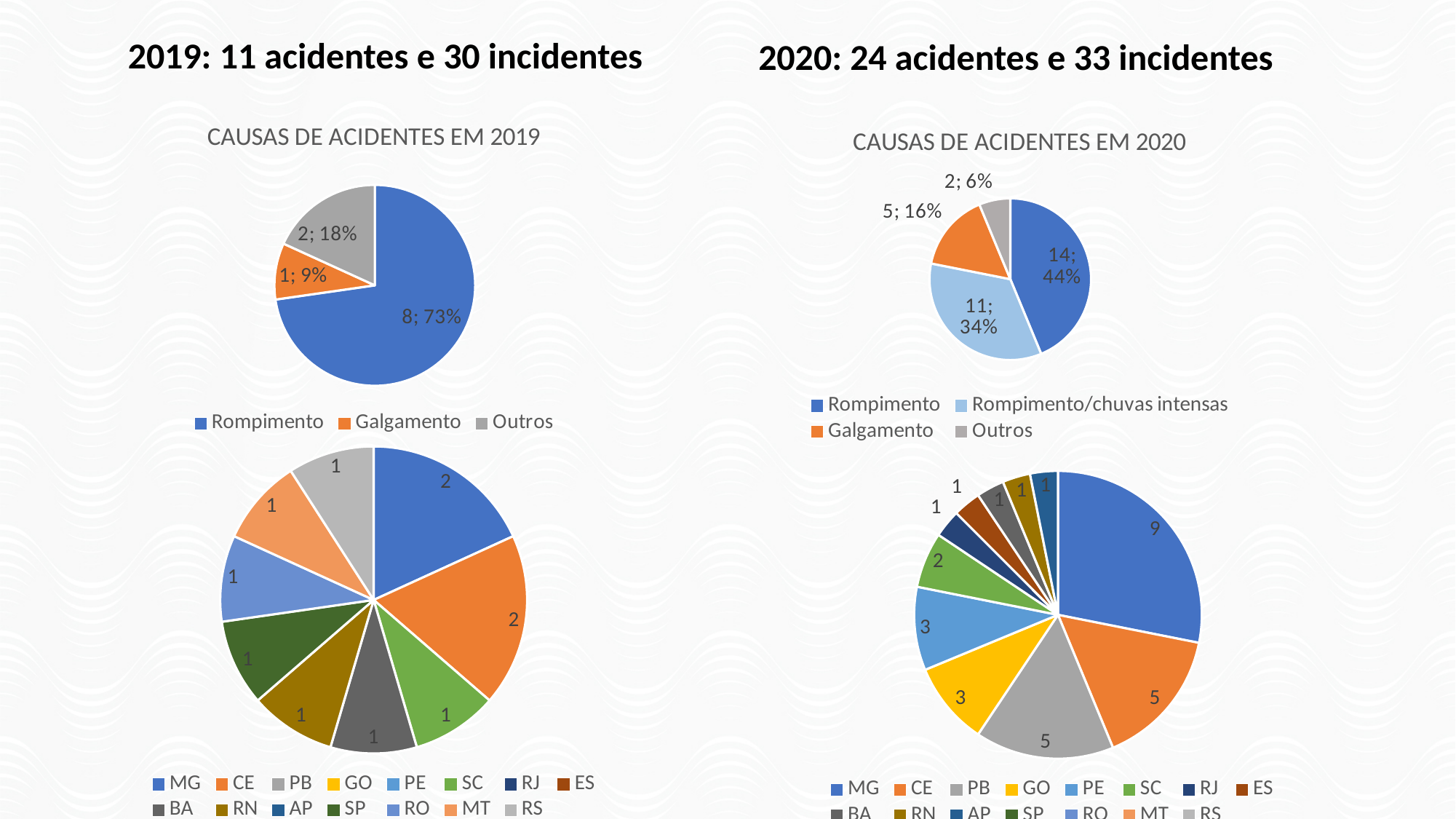
In the bottom-right pie chart (2020 by state), is the value for MG larger or smaller than the value for CE? larger In the bottom-right pie chart (2020 by state), which state has the largest slice? MG In the chart titled "CAUSAS DE ACIDENTES EM 2020", what value is shown for Rompimento/chuvas intensas? 11; 34% In the chart titled "CAUSAS DE ACIDENTES EM 2019", what share of the pie does Outros have? 18% In the bottom-right pie chart (2020 by state), what value is shown for MG? 9 In the chart titled "CAUSAS DE ACIDENTES EM 2019", what value is shown for Rompimento? 8; 73% In the chart titled "CAUSAS DE ACIDENTES EM 2019", which category has the smallest slice? Galgamento How many categories does the legend of the chart titled "CAUSAS DE ACIDENTES EM 2020" list? 4 What kind of chart is the chart titled "CAUSAS DE ACIDENTES EM 2019"? pie chart In the chart titled "CAUSAS DE ACIDENTES EM 2020", which category has the largest slice? Rompimento In the chart titled "CAUSAS DE ACIDENTES EM 2020", what is the difference between the counts for Rompimento and Galgamento? 9 In the bottom-left pie chart (2019 by state), what value is shown for MG? 2